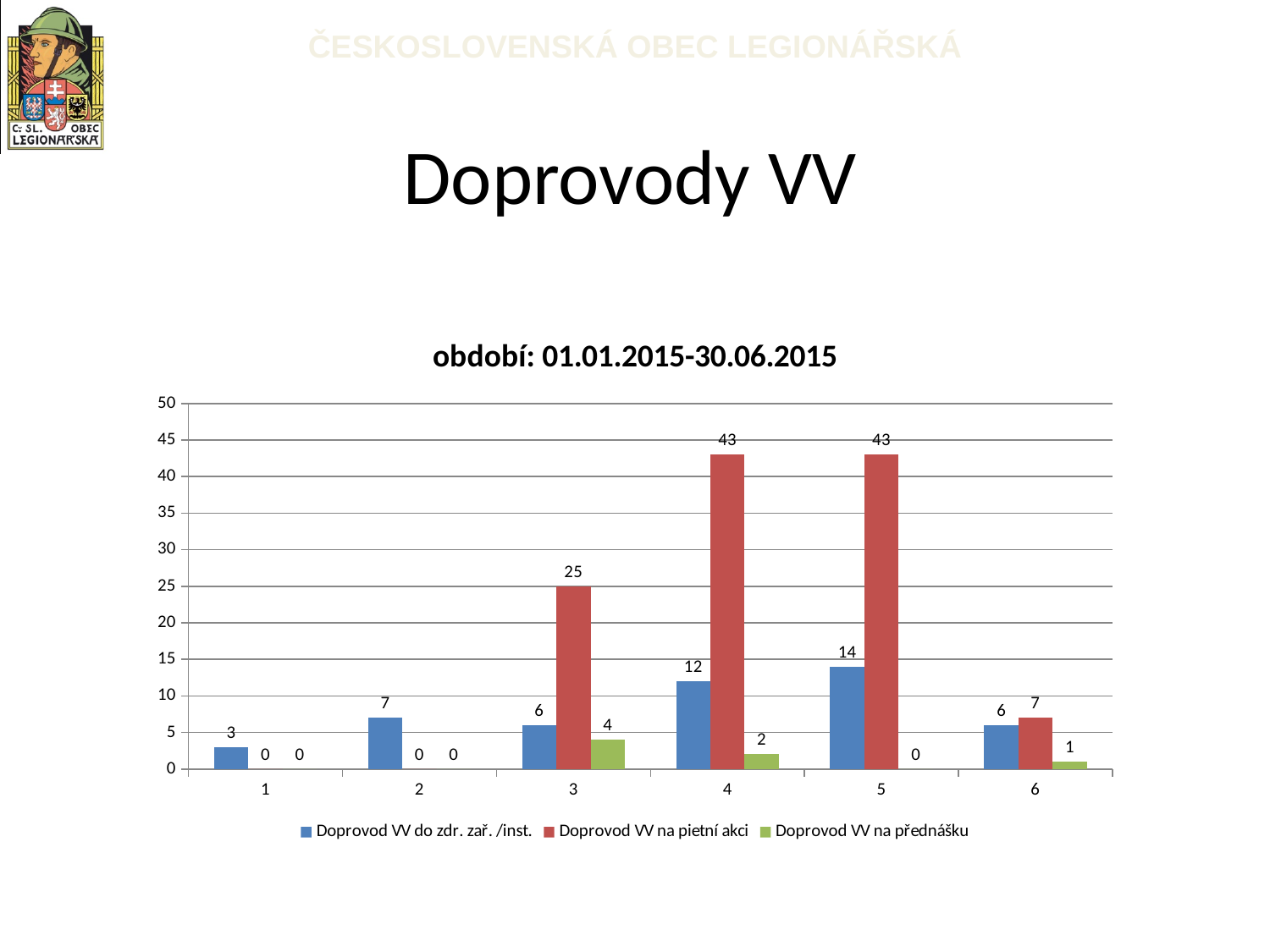
What period does the chart title state? 01.01.2015-30.06.2015 What is the value of 'Doprovod VV na pietní akci' for category 4? 43 What is the difference between 'Doprovod VV na pietní akci' and 'Doprovod VV do zdr. zař. /inst.' for category 4? 31 What is the value of 'Doprovod VV do zdr. zař. /inst.' for category 5? 14 What is the value of 'Doprovod VV na přednášku' for category 3? 4 What is the value of 'Doprovod VV na pietní akci' for category 3? 25 What kind of chart is shown on the slide? bar chart Which category has the lowest value for 'Doprovod VV do zdr. zař. /inst.'? 1 How many categories are shown on the x axis? 6 Which is larger for category 6: 'Doprovod VV do zdr. zař. /inst.' or 'Doprovod VV na pietní akci'? Doprovod VV na pietní akci How many series does the legend list? 3 Which category has the highest value for 'Doprovod VV do zdr. zař. /inst.'? 5